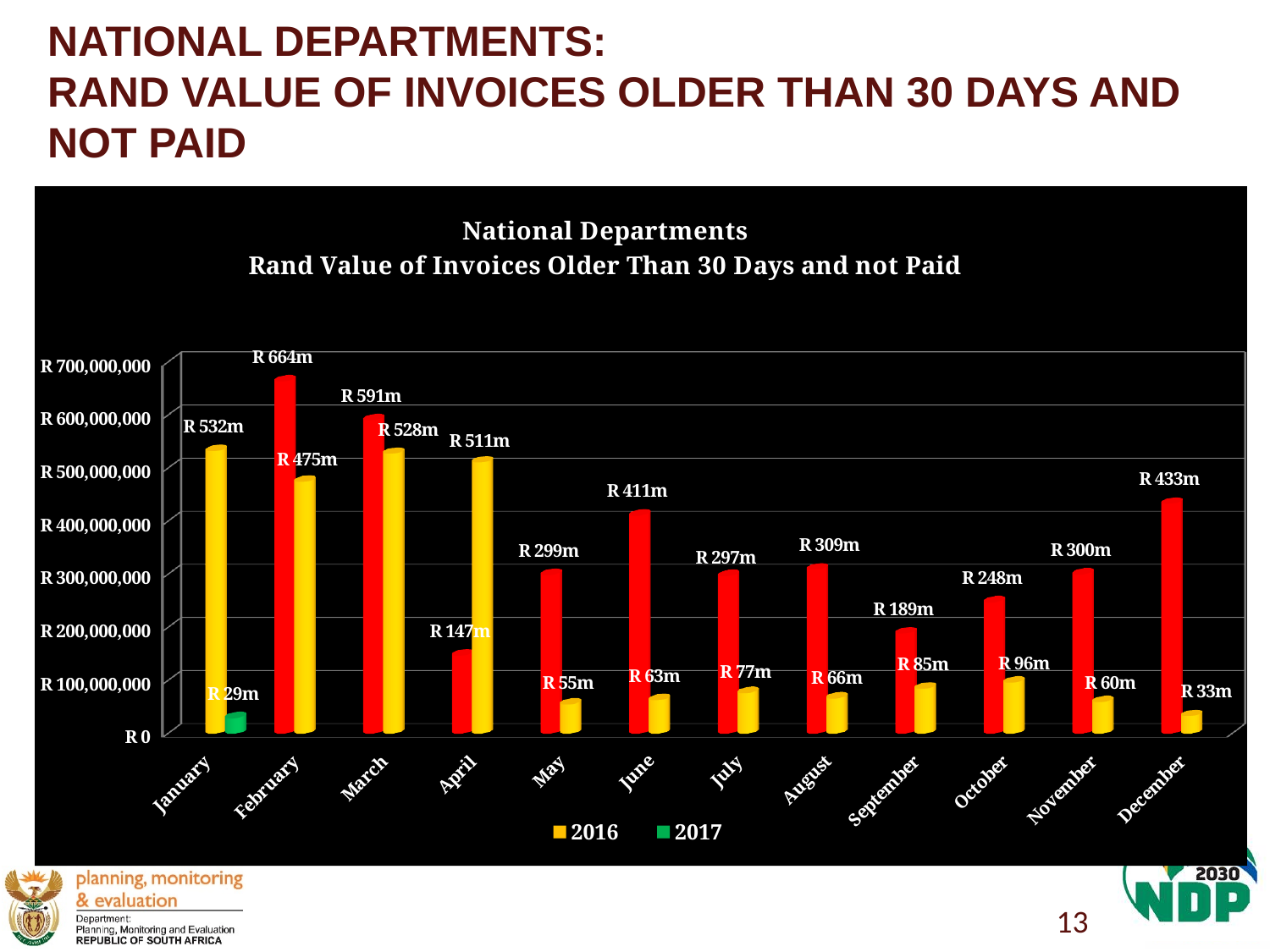
What is the value of the red bar for June? R 411m Which month has the highest 2016 value? January What is the 2017 value for January? R 29m How many series does the legend list? 2 How many months are shown on the x axis? 12 What kind of chart is shown on the slide? bar chart Is the value of the red bar for February greater or less than R 600,000,000? greater What is the 2016 value for January? R 532m What is the 2016 value for March? R 528m Which is larger, the 2016 value for February or the 2016 value for April? April What is the difference between the 2016 values for January and December? R 499m Which month has the lowest 2016 value? December